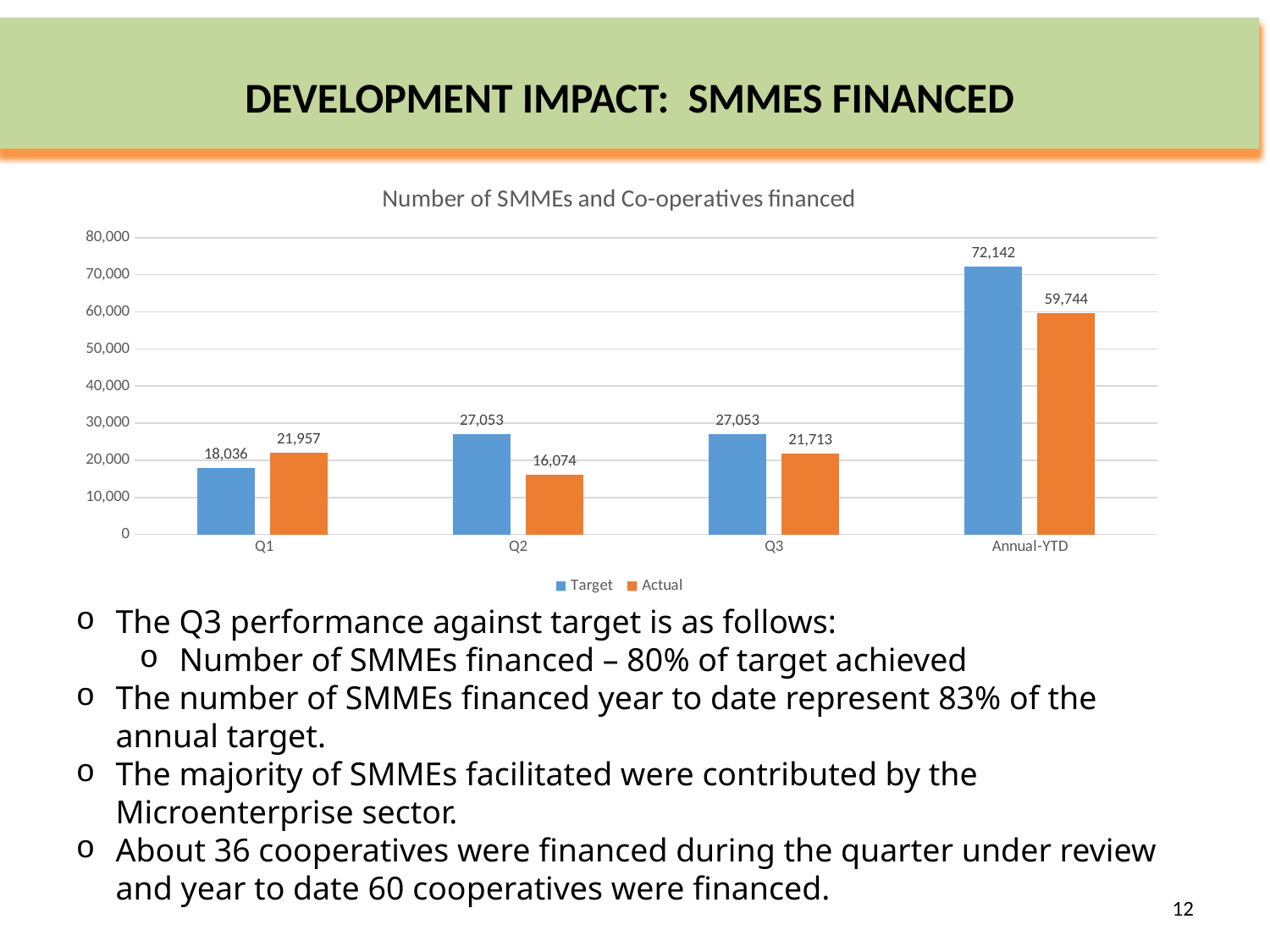
Which is larger for Q1, the Target or the Actual value? Actual What is the Actual value for Annual-YTD? 59,744 How many series does the legend list? 2 Which category has the highest Target value? Annual-YTD What is the Actual value for Q2? 16,074 How many categories are shown on the x axis? 4 What is the difference between the Target and Actual values for Annual-YTD? 12,398 Which category has the lowest Actual value? Q2 What is the Target value for Q3? 27,053 What is the Target value for Q1? 18,036 What is the title of the chart? Number of SMMEs and Co-operatives financed What kind of chart is shown on the slide? Bar chart